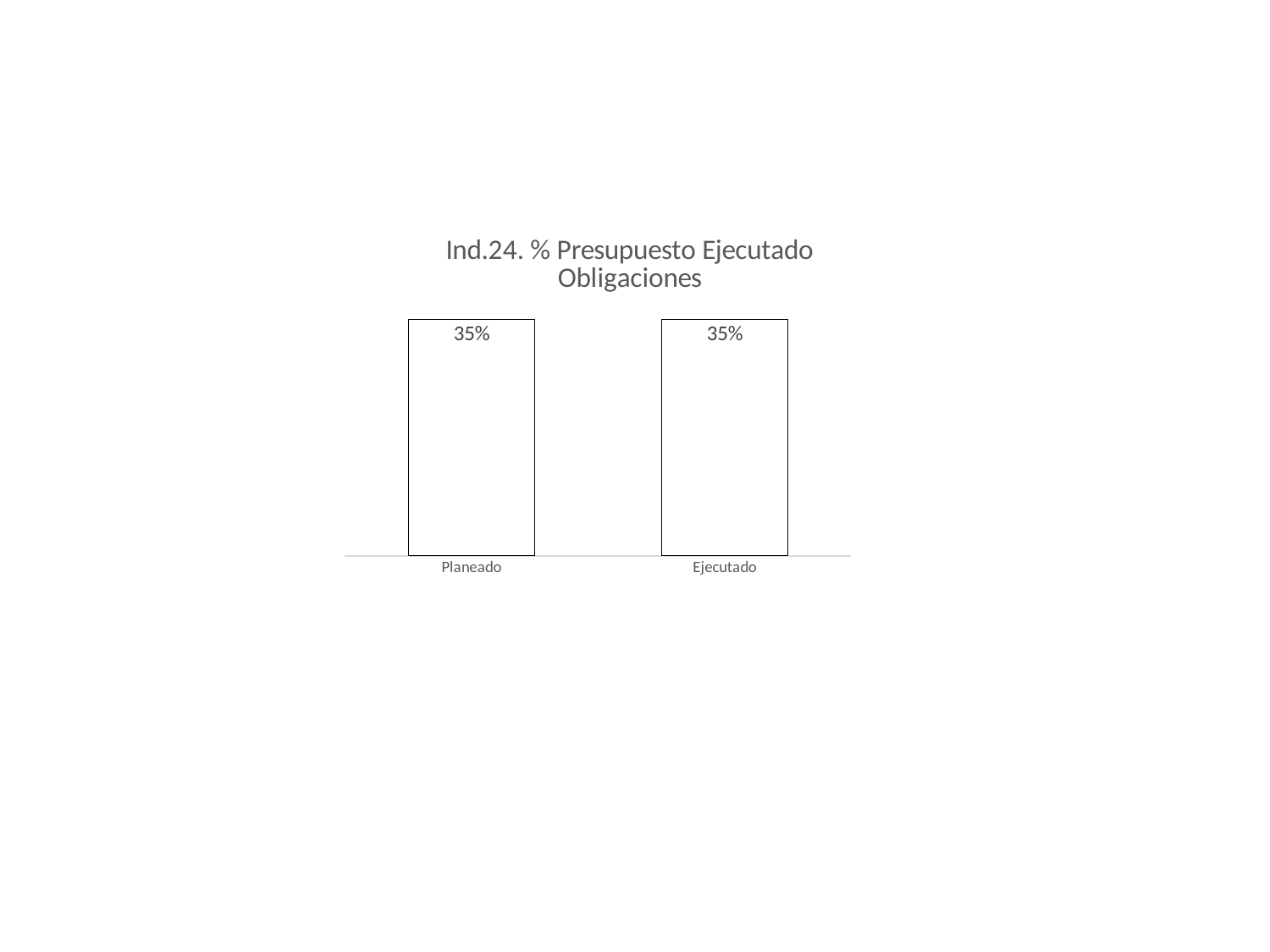
What is the value for Ejecutado? 35% What is the difference between the Planeado and Ejecutado values? 0% What is the value for Planeado? 35% What is the title of the chart? Ind.24. % Presupuesto Ejecutado Obligaciones Are the values for Planeado and Ejecutado equal? yes What kind of chart is this? bar chart How many categories are shown on the x axis? 2 Which category is shown on the left of the chart? Planeado